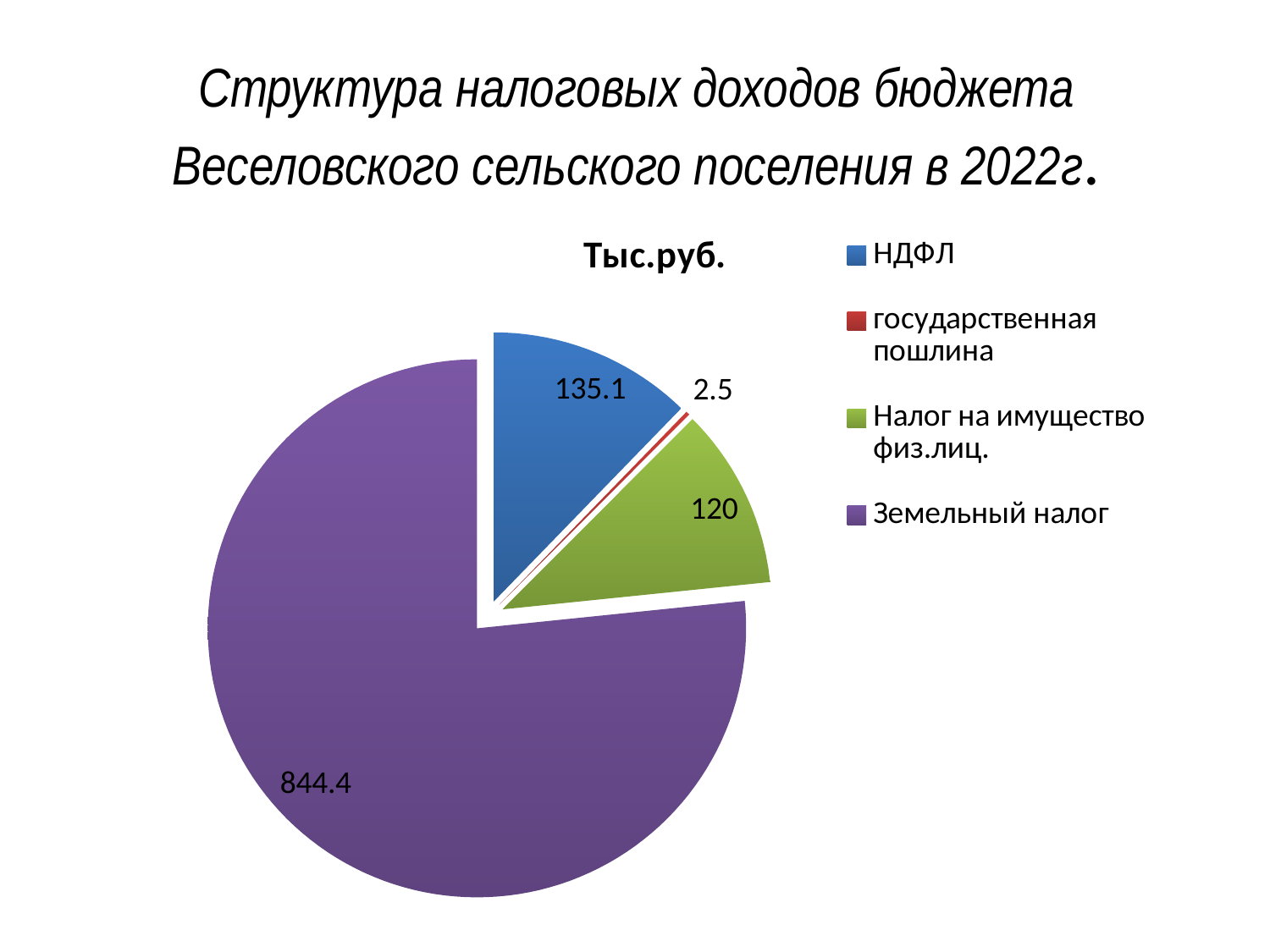
How many slices does the pie chart have? 4 What is the value for Налог на имущество физ.лиц. in the pie chart? 120 What is the value for НДФЛ in the pie chart? 135.1 Which category has the largest slice in the pie chart? Земельный налог What is the difference between the values for Земельный налог and НДФЛ? 709.3 What is the value for Земельный налог in the pie chart? 844.4 What is the difference between the values for НДФЛ and Налог на имущество физ.лиц.? 15.1 What is the title shown above the pie chart? Тыс.руб. Which category has the smallest slice in the pie chart? государственная пошлина What kind of chart is shown on the slide? Pie chart What is the value for государственная пошлина in the pie chart? 2.5 Which is larger, the value for НДФЛ or the value for Налог на имущество физ.лиц.? НДФЛ